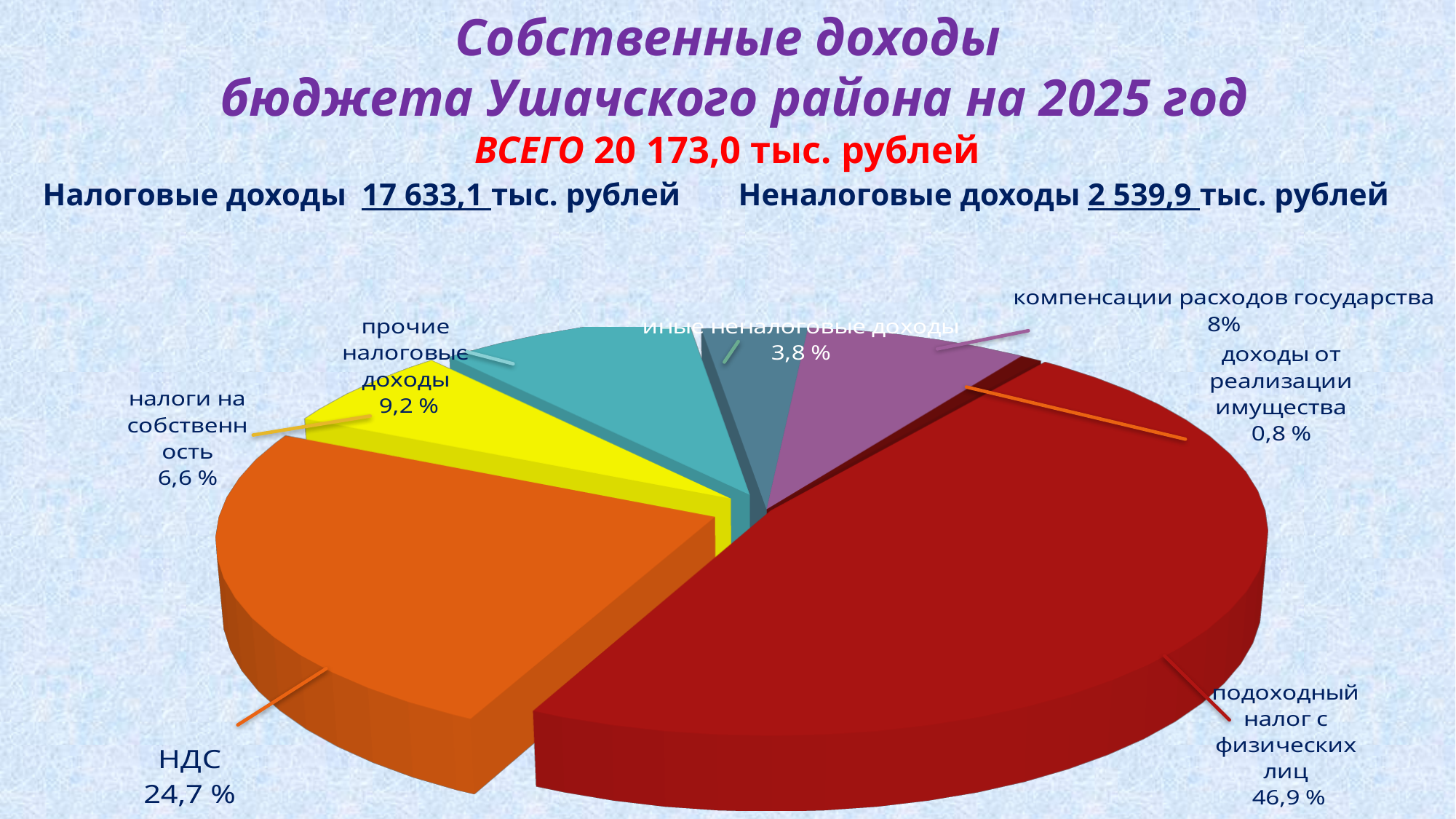
What is the value shown for "компенсации расходов государства"? 8% What is the value shown for "налоги на собственность"? 6,6 % What type of chart is shown on the slide? pie chart Which category has the smallest share of the pie? доходы от реализации имущества What is the value shown for "прочие налоговые доходы"? 9,2 % What is the value shown for "доходы от реализации имущества"? 0,8 % Which category has the largest share of the pie? подоходный налог с физических лиц What share of the pie does "подоходный налог с физических лиц" have? 46,9 % What is the value shown for "НДС"? 24,7 % What is the difference in percentage points between "подоходный налог с физических лиц" and "НДС"? 22,2 Which is larger: "иные неналоговые доходы" or "налоги на собственность"? налоги на собственность How many slices does the pie chart have? 7